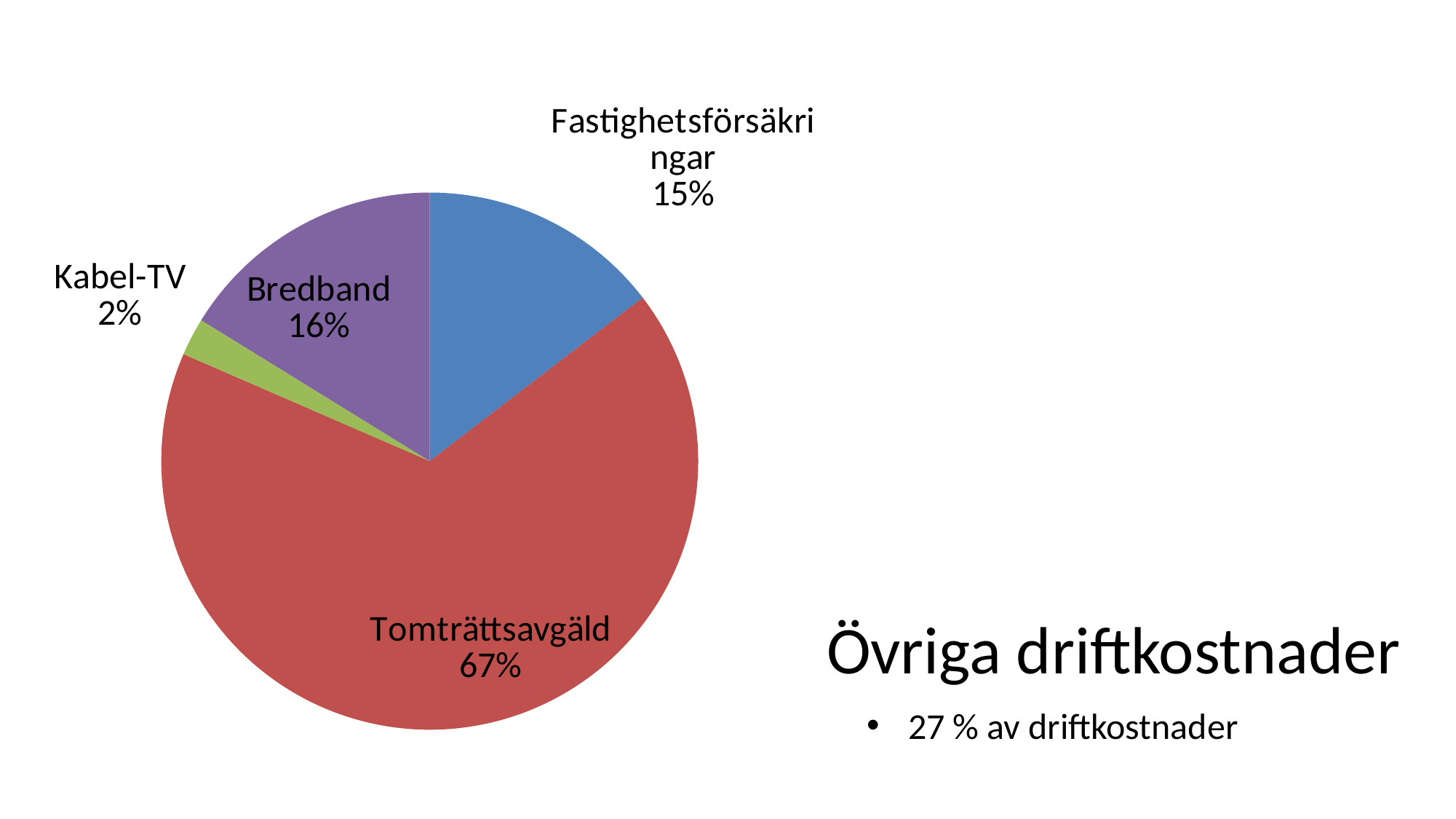
How many slices does the pie chart have? 4 Which is larger, the slice for Bredband or the slice for Fastighetsförsäkringar? Bredband What share of the pie does Tomträttsavgäld represent? 67% What colour is the Tomträttsavgäld slice? Red What share of the pie does Kabel-TV represent? 2% Which category has the smallest slice of the pie? Kabel-TV What share of the pie does Bredband represent? 16% Which category has the largest slice of the pie? Tomträttsavgäld What is the difference in percentage points between Bredband and Kabel-TV? 14 What is the difference in percentage points between Tomträttsavgäld and Bredband? 51 What kind of chart is shown on the slide? Pie chart